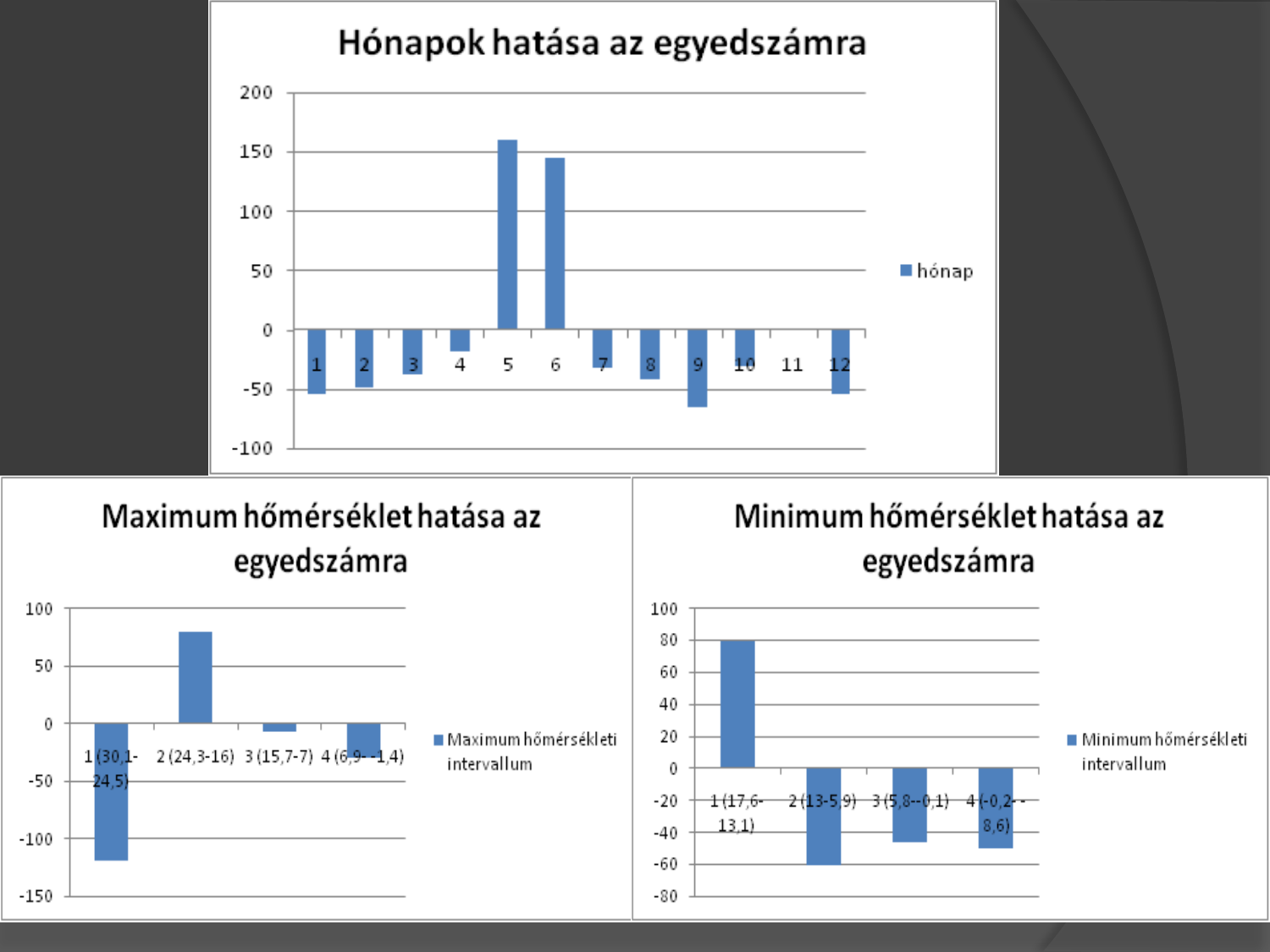
In the chart titled 'Hónapok hatása az egyedszámra', is the value for month 5 greater or less than 150? greater What is the legend entry in the chart titled 'Hónapok hatása az egyedszámra'? hónap In the chart titled 'Hónapok hatása az egyedszámra', which month has the highest value? 5 In the chart titled 'Maximum hőmérséklet hatása az egyedszámra', is the value for category 1 (30,1-24,5) greater or less than -100? less In the chart titled 'Hónapok hatása az egyedszámra', which month has the lowest value? 9 In the chart titled 'Hónapok hatása az egyedszámra', how many months are shown on the x axis? 12 In the chart titled 'Maximum hőmérséklet hatása az egyedszámra', which category has the highest value? 2 (24,3-16) What kind of chart is 'Minimum hőmérséklet hatása az egyedszámra'? bar chart In the chart titled 'Hónapok hatása az egyedszámra', which is larger, the value for month 5 or the value for month 6? month 5 In the chart titled 'Minimum hőmérséklet hatása az egyedszámra', is the value for category 1 (17,6-13,1) greater or less than 60? greater In the chart titled 'Minimum hőmérséklet hatása az egyedszámra', which category has the lowest value? 2 (13-5,9)